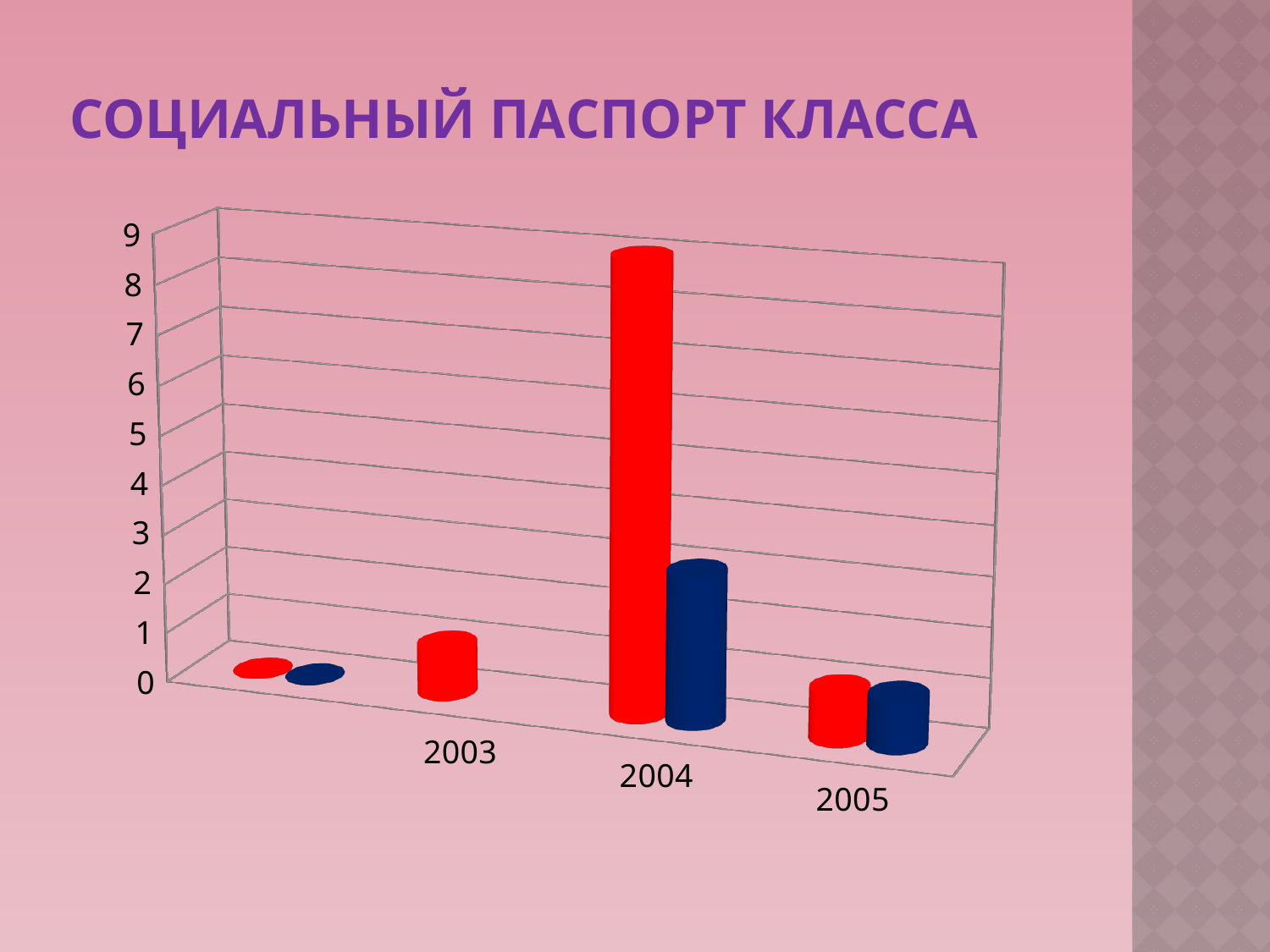
Is the value of the red bar for 2004 greater or less than 5? greater What two colours are used for the bars in the chart? red and blue What is the title of the slide with the chart? СОЦИАЛЬНЫЙ ПАСПОРТ КЛАССА Which year has the tallest red bar? 2004 Is the value of the blue bar for 2005 greater or less than 3? less In 2004, which bar is taller, the red one or the blue one? the red one Is the value of the red bar for 2004 greater or less than 7? greater Does the red bar rise or fall from 2004 to 2005? fall What kind of chart is shown on the slide? bar chart What is the highest value shown on the vertical axis? 9